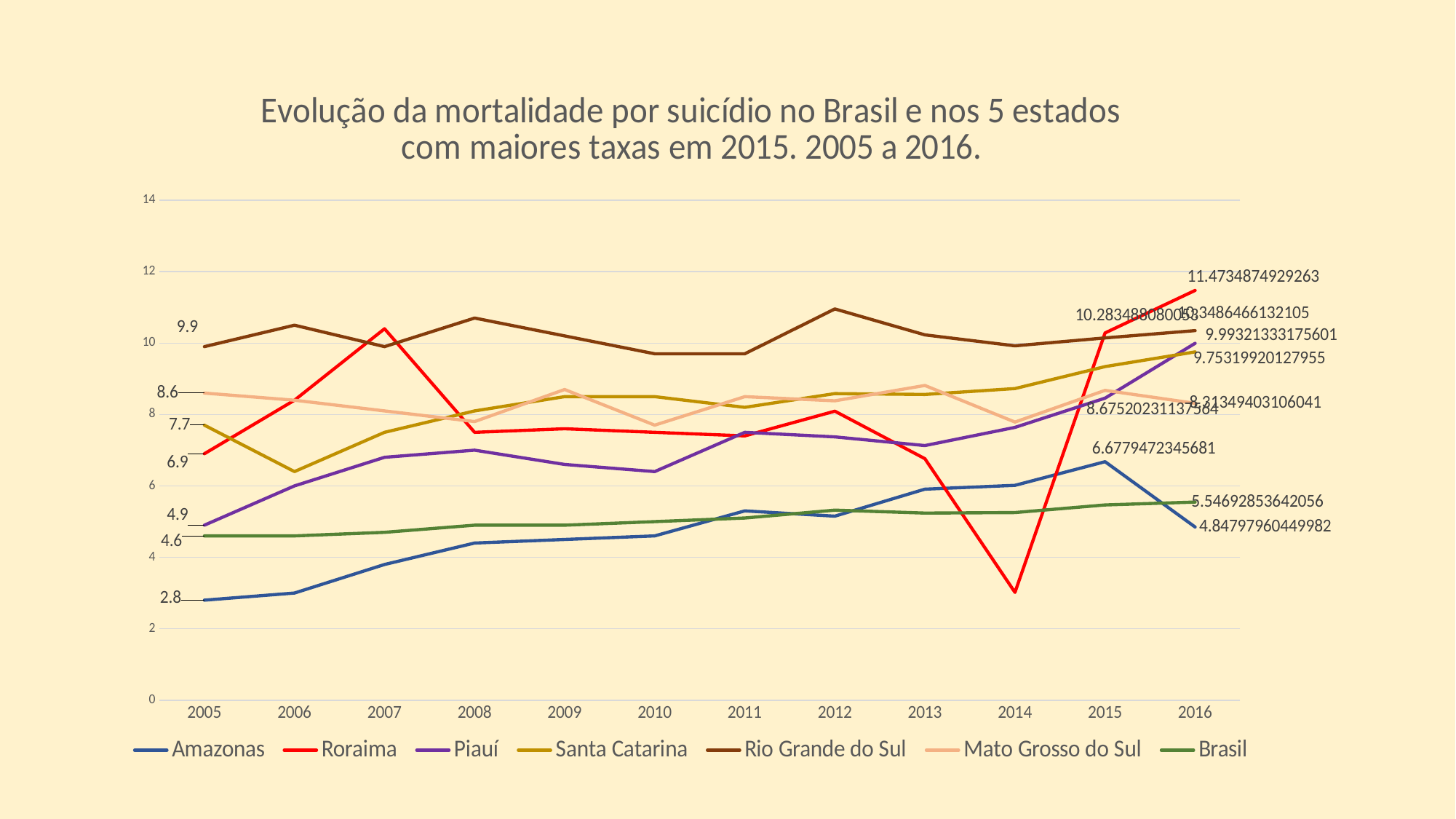
What kind of chart is shown on the slide? line chart Which series has the lowest value in 2005? Amazonas How many years are shown along the x axis? 12 Is the value for Roraima in 2014 greater or less than 4? less Which series has the highest value in 2005? Rio Grande do Sul What is the value for Roraima in 2016? 11.4734874929263 Does the Brasil line rise or fall from 2005 to 2016? rise What is the difference between the 2005 values for Rio Grande do Sul and Amazonas? 7.1 What is the value for Brasil in 2016? 5.54692853642056 What is the value for Rio Grande do Sul in 2005? 9.9 What is the value for Amazonas in 2005? 2.8 How many series does the legend list? 7